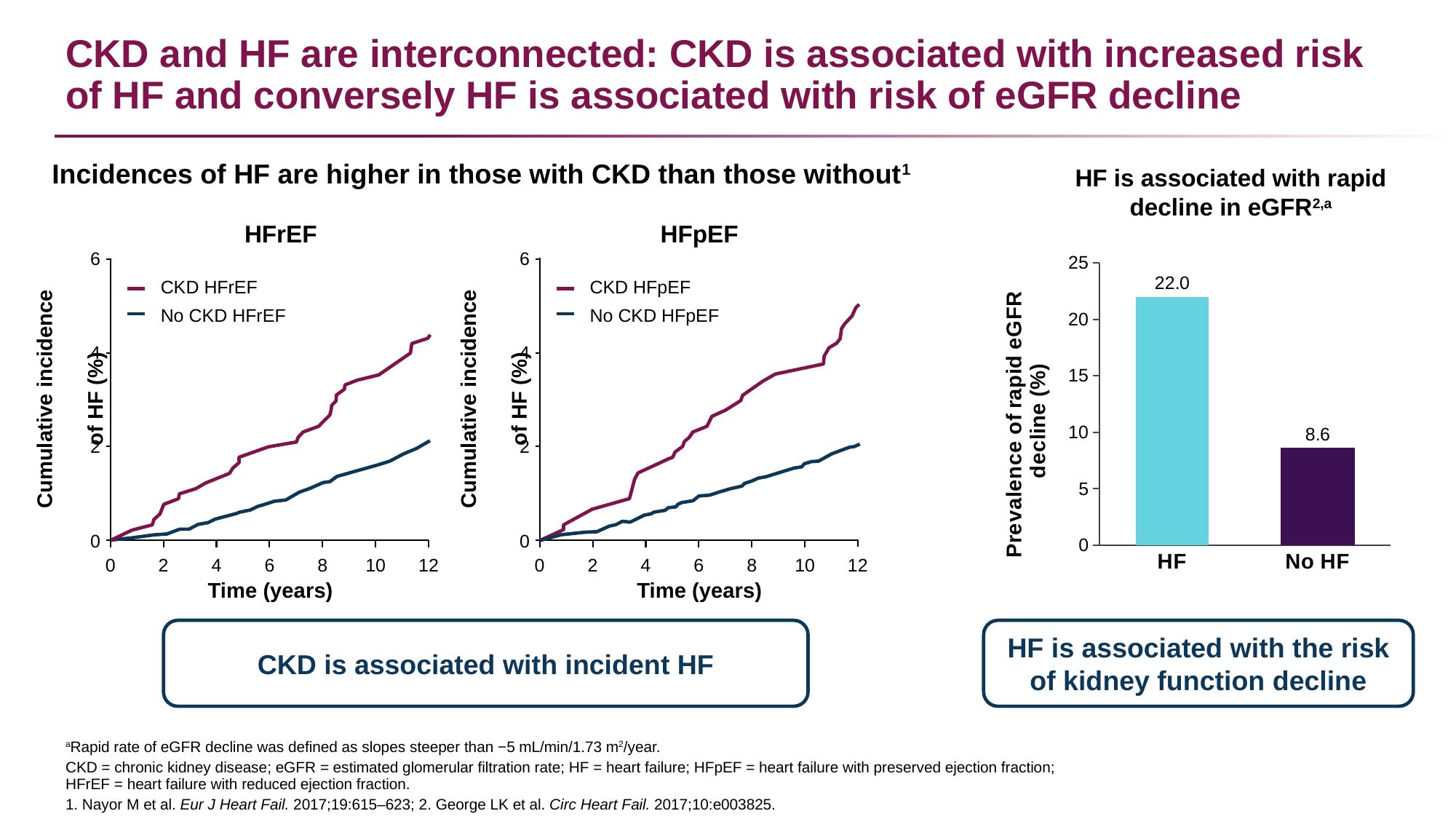
In the HFrEF chart, does the cumulative incidence of HF rise or fall over time? Rise In the bar chart titled 'HF is associated with rapid decline in eGFR', which group has the higher prevalence of rapid eGFR decline? HF In the HFrEF chart, is the cumulative incidence for No CKD HFrEF at 12 years greater or less than 4? less In the bar chart titled 'HF is associated with rapid decline in eGFR', what is the prevalence of rapid eGFR decline for the HF group? 22.0 In the HFrEF chart, how many series does the legend list? 2 In the bar chart titled 'HF is associated with rapid decline in eGFR', what is the difference between the HF and No HF values? 13.4 In the HFpEF chart, is the cumulative incidence for CKD HFpEF at 12 years greater or less than 4? greater In the HFpEF chart, what are the two series named in the legend? CKD HFpEF and No CKD HFpEF In the HFpEF chart, at 12 years, which series has the higher cumulative incidence of HF: CKD HFpEF or No CKD HFpEF? CKD HFpEF In the bar chart titled 'HF is associated with rapid decline in eGFR', what is the prevalence of rapid eGFR decline for the No HF group? 8.6 In the bar chart titled 'HF is associated with rapid decline in eGFR', how many categories are shown on the x axis? 2 What kind of chart is the chart titled 'HF is associated with rapid decline in eGFR'? Bar chart